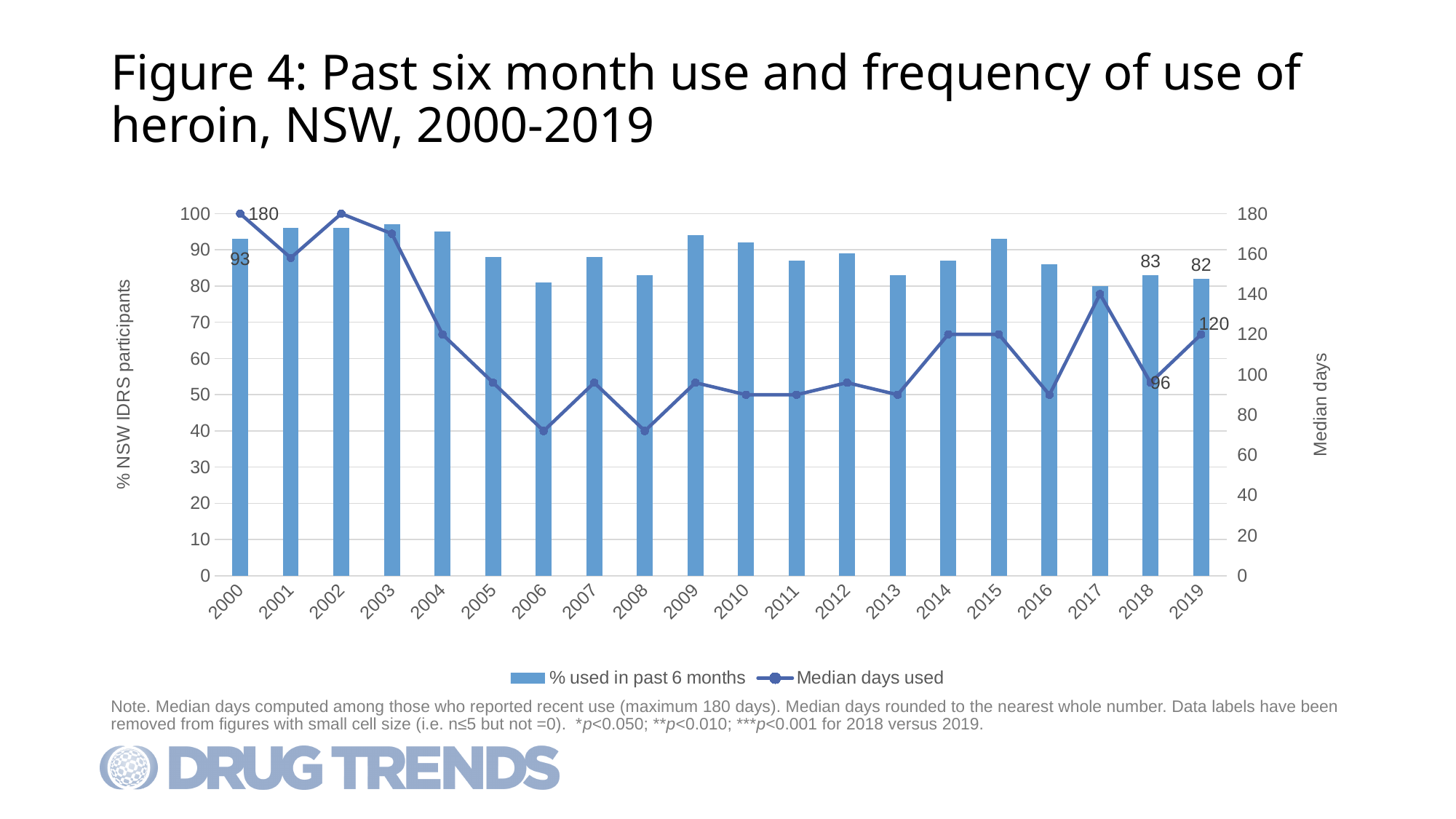
What was the median days used in 2000? 180 What percentage of participants used heroin in the past 6 months in 2018? 83 How many years are shown on the x axis? 20 Which year had the higher median days used, 2018 or 2019? 2019 What percentage of NSW IDRS participants reported using heroin in the past 6 months in 2000? 93 By how much did the median days used increase from 2018 to 2019? 24 Is the median days used in 2006 greater or less than 80? less Which year has the lowest % used in past 6 months? 2017 How many series does the legend list? 2 What was the median days used in 2018? 96 What is the difference between the % used in past 6 months in 2018 and in 2019? 1 What was the median days used in 2019? 120